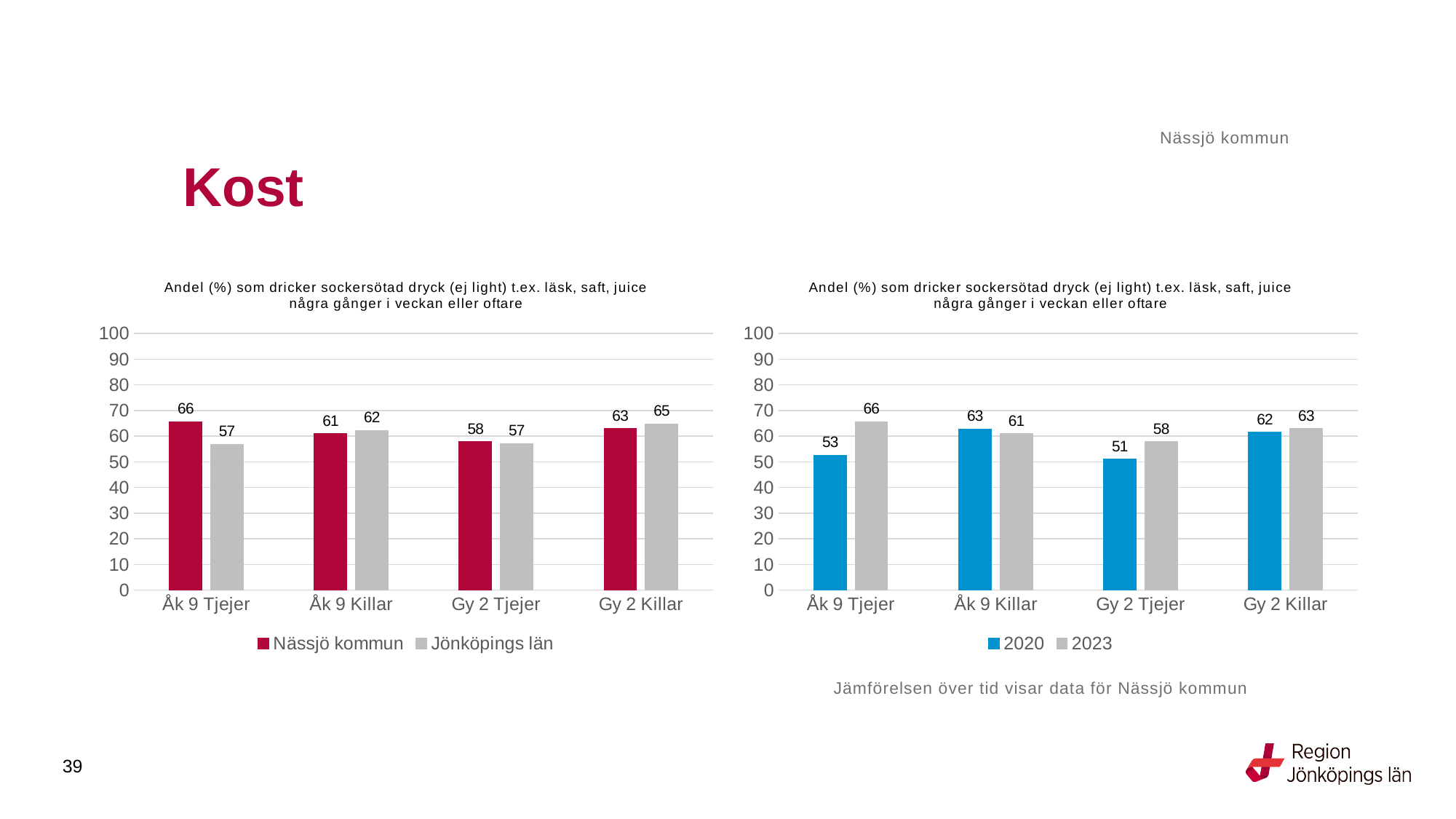
In the left chart, which is larger for Gy 2 Killar: Nässjö kommun or Jönköpings län? Jönköpings län In the right chart, what is the value for 2020 for Gy 2 Tjejer? 51 What kind of chart is the left chart? Bar chart In the right chart, which category has the highest value for 2020? Åk 9 Killar In the right chart, what is the value for 2023 for Åk 9 Tjejer? 66 How many categories are shown on the x axis of the right chart? 4 In the right chart, what is the difference between 2023 and 2020 for Åk 9 Tjejer? 13 In the left chart, what is the value for Nässjö kommun for Åk 9 Tjejer? 66 In the right chart, which is larger for Åk 9 Killar: 2020 or 2023? 2020 In the left chart, what is the value for Jönköpings län for Gy 2 Killar? 65 In the left chart, what is the difference between Nässjö kommun and Jönköpings län for Åk 9 Tjejer? 9 In the left chart, which category has the lowest value for Nässjö kommun? Gy 2 Tjejer